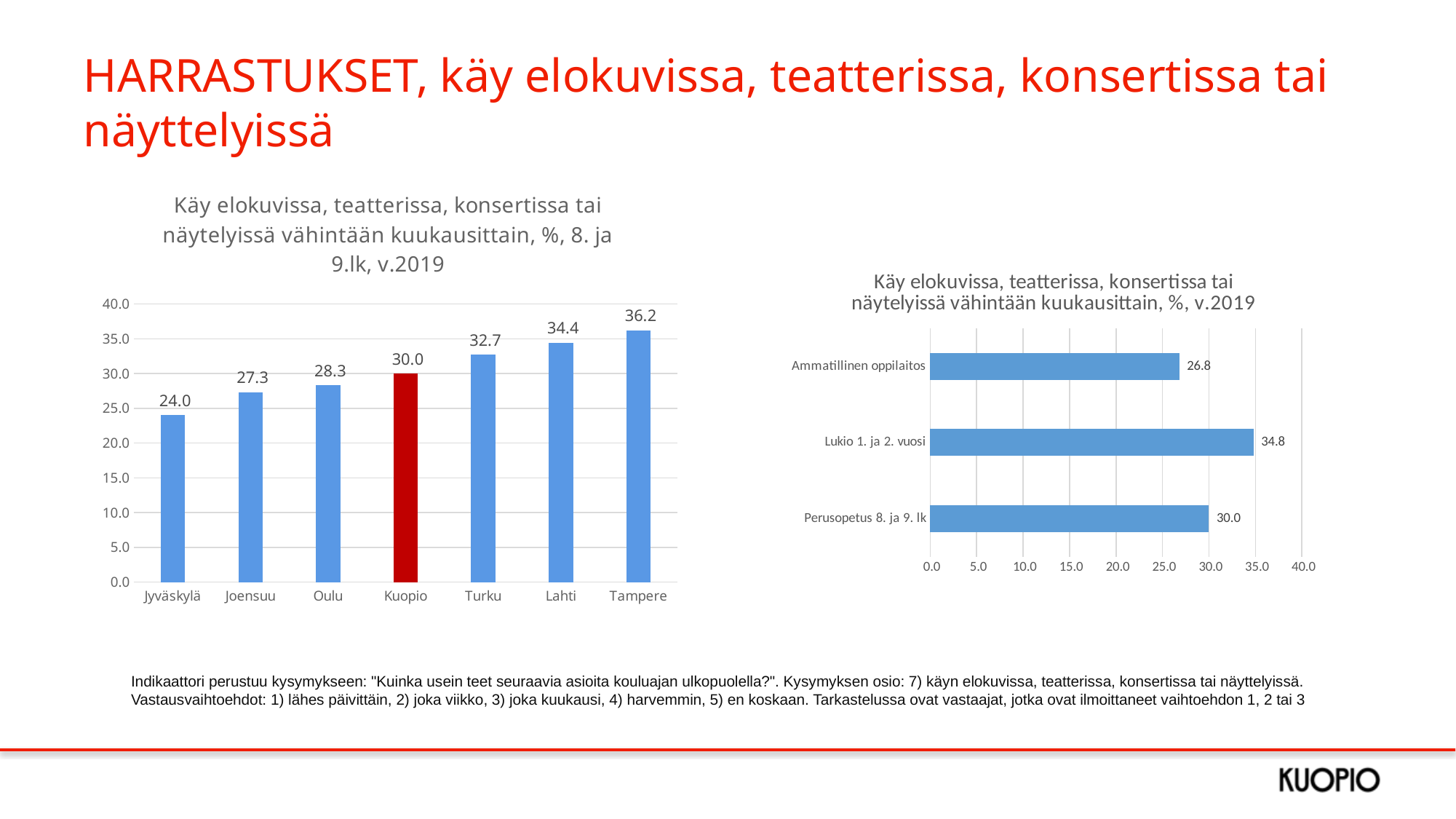
In the left chart (8. ja 9.lk, v.2019), which city has the lowest value? Jyväskylä In the left chart (8. ja 9.lk, v.2019), which city has the highest value? Tampere In the left chart (8. ja 9.lk, v.2019), what is the value for Kuopio? 30.0 In the right chart (v.2019), what is the value for Lukio 1. ja 2. vuosi? 34.8 In the left chart (8. ja 9.lk, v.2019), which is larger, Oulu or Joensuu? Oulu In the right chart (v.2019), what is the difference between Lukio 1. ja 2. vuosi and Ammatillinen oppilaitos? 8.0 In the right chart (v.2019), which category has the lowest value? Ammatillinen oppilaitos What kind of chart is the right chart (v.2019)? bar chart In the left chart (8. ja 9.lk, v.2019), which bar is coloured red? Kuopio In the left chart (8. ja 9.lk, v.2019), how many cities are shown? 7 In the left chart (8. ja 9.lk, v.2019), do the values rise or fall from Jyväskylä to Tampere? rise In the left chart (8. ja 9.lk, v.2019), what is the difference between Tampere and Jyväskylä? 12.2